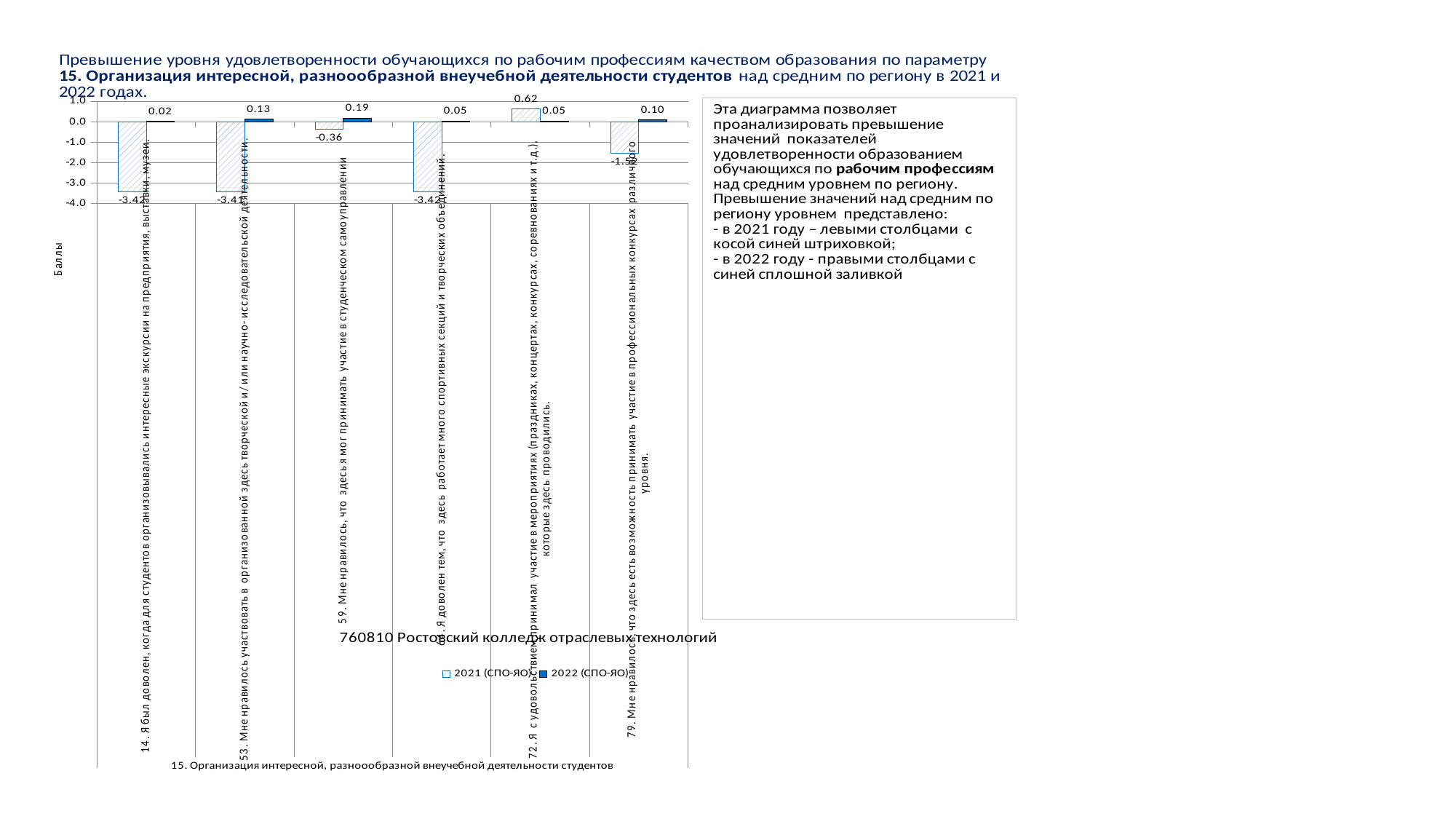
What is the difference between the 2022 and 2021 values for item 59 (student self-government)? 0.55 Which item has the lowest 2022 (СПО-ЯО) value? 14. Я был доволен, когда для студентов организовывались интересные экскурсии на предприятия, выставки, музеи. Which item has the highest 2021 (СПО-ЯО) value? 72. Я с удовольствием принимал участие в мероприятиях (праздниках, концертах, конкурсах, соревнованиях и т.д.), которые здесь проводились. What is the 2022 (СПО-ЯО) value for item 59 (participation in student self-government)? 0.19 What is the 2021 (СПО-ЯО) value for item 72 (participation in events such as holidays, concerts, contests)? 0.62 Which item has the highest 2022 (СПО-ЯО) value? 59. Мне нравилось, что здесь я мог принимать участие в студенческом самоуправлении Which is larger: the 2022 value for item 53 (creative/research activity) or the 2022 value for item 79 (professional contests)? item 53 (0.13) What kind of chart is shown on the slide? bar chart How many series does the chart legend list? 2 Is the 2021 (СПО-ЯО) value for item 79 (professional contests) greater or less than -1.0? less What is the 2021 (СПО-ЯО) value for item 14 (excursions to enterprises, exhibitions, museums)? -3.42 How many categories (survey items) are plotted on the x axis? 6